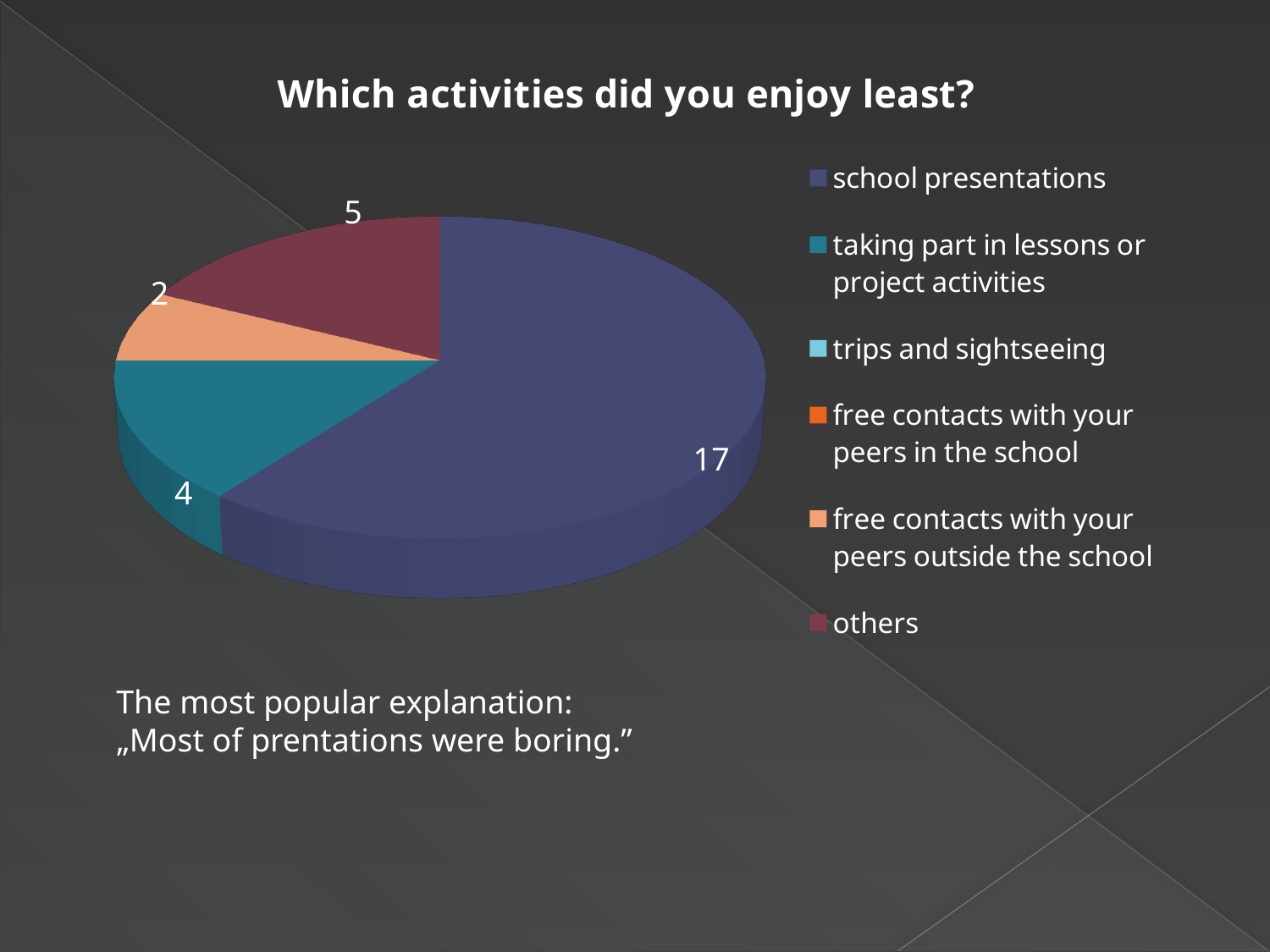
What value is shown for taking part in lessons or project activities? 4 What kind of chart is shown on the slide? pie chart What is the title of the chart? Which activities did you enjoy least? Which category has the largest slice of the pie? school presentations What value is shown for school presentations? 17 What value is shown for free contacts with your peers outside the school? 2 What is the difference between the values for school presentations and taking part in lessons or project activities? 13 Which is larger, the value for others or the value for taking part in lessons or project activities? others What value is shown for others? 5 How many entries does the legend list? 6 What is the difference between the values for others and free contacts with your peers outside the school? 3 Which is larger, the value for school presentations or the value for others? school presentations